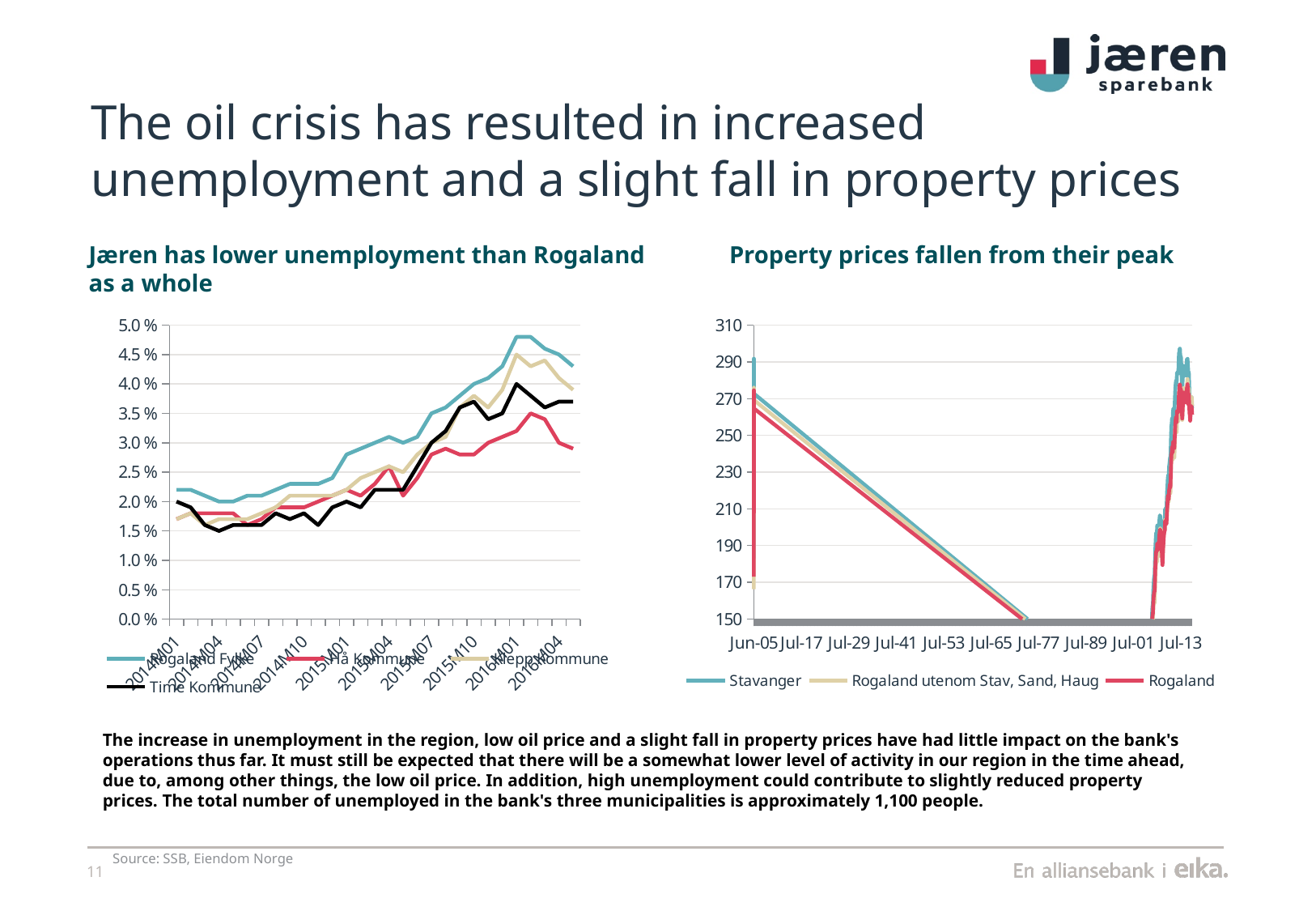
In the chart titled 'Jæren has lower unemployment than Rogaland as a whole', do the unemployment values generally rise or fall from 2014 to 2016? rise In the chart titled 'Jæren has lower unemployment than Rogaland as a whole', which series reaches the highest value? Rogaland Fylke In the chart titled 'Property prices fallen from their peak', which series is shown in red? Rogaland How many series does the legend list in the chart titled 'Property prices fallen from their peak'? 3 What type of chart is the chart titled 'Jæren has lower unemployment than Rogaland as a whole'? line chart In the chart titled 'Jæren has lower unemployment than Rogaland as a whole', is the peak value for Rogaland Fylke greater or less than 4.5 %? greater What type of chart is the chart titled 'Property prices fallen from their peak'? line chart In the chart titled 'Property prices fallen from their peak', is the peak value for Stavanger greater or less than 270? greater In the chart titled 'Jæren has lower unemployment than Rogaland as a whole', is the peak value for Hå Kommune greater or less than 4.0 %? less In the chart titled 'Jæren has lower unemployment than Rogaland as a whole', which series has the lowest value at the end of the period? Hå Kommune How many series does the legend list in the chart titled 'Jæren has lower unemployment than Rogaland as a whole'? 4 In the chart titled 'Jæren has lower unemployment than Rogaland as a whole', which is larger at the end of the period: Rogaland Fylke or Time Kommune? Rogaland Fylke